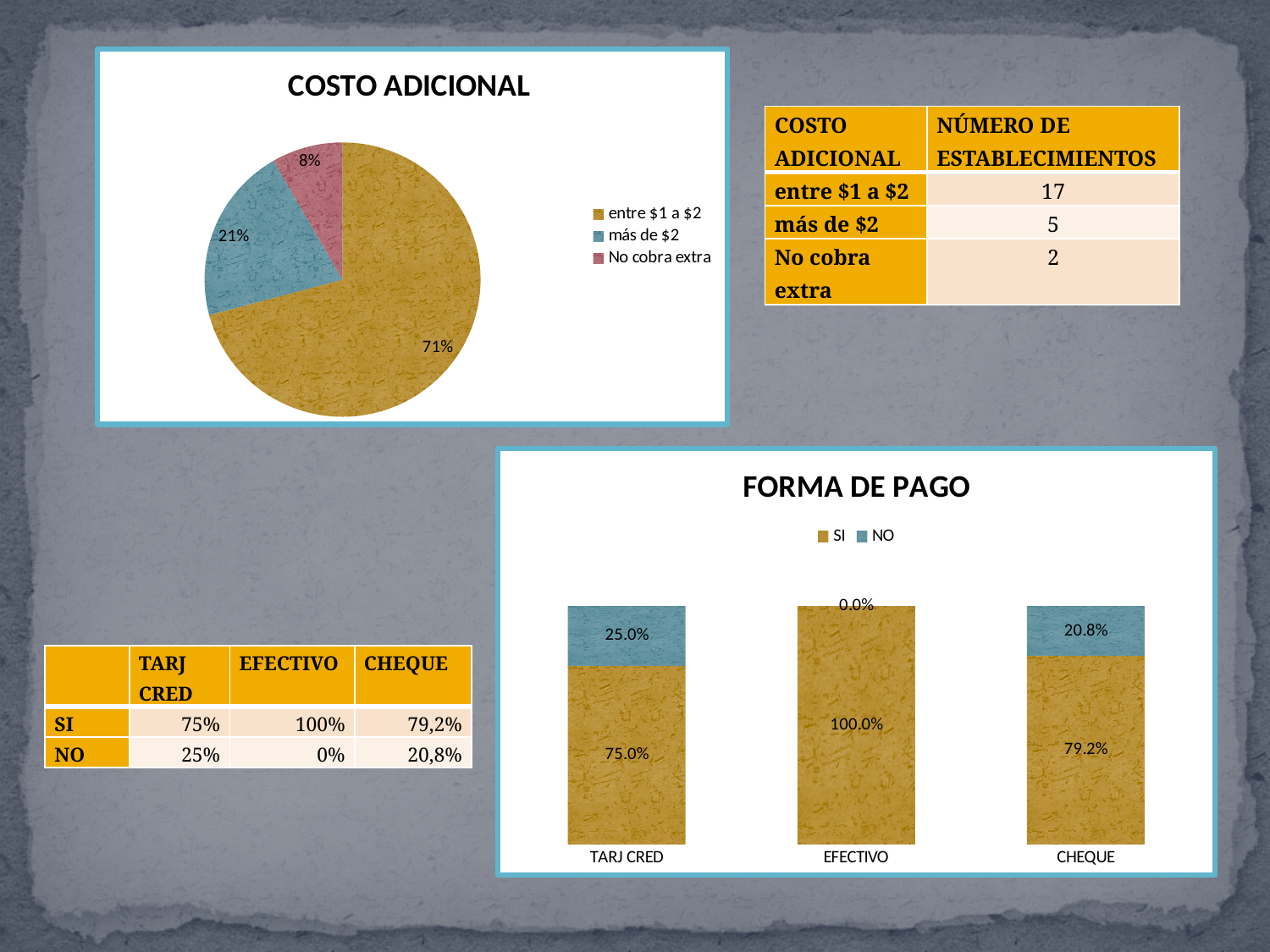
In the COSTO ADICIONAL chart, what percentage is shown for 'No cobra extra'? 8% In the FORMA DE PAGO chart, what kind of chart is shown? stacked bar chart In the FORMA DE PAGO chart, which payment method has the highest SI value? EFECTIVO In the FORMA DE PAGO chart, what is the SI value for CHEQUE? 79.2% In the COSTO ADICIONAL chart, which category has the smallest slice? No cobra extra In the COSTO ADICIONAL chart, how many slices does the pie have? 3 In the COSTO ADICIONAL chart, what kind of chart is shown? pie chart In the COSTO ADICIONAL chart, what percentage is shown for 'entre $1 a $2'? 71% In the COSTO ADICIONAL chart, what is the difference in percentage points between 'entre $1 a $2' and 'más de $2'? 50 In the FORMA DE PAGO chart, what is the NO value for TARJ CRED? 25.0% In the FORMA DE PAGO chart, is the NO value larger for TARJ CRED or for CHEQUE? TARJ CRED In the FORMA DE PAGO chart, how many series does the legend list? 2